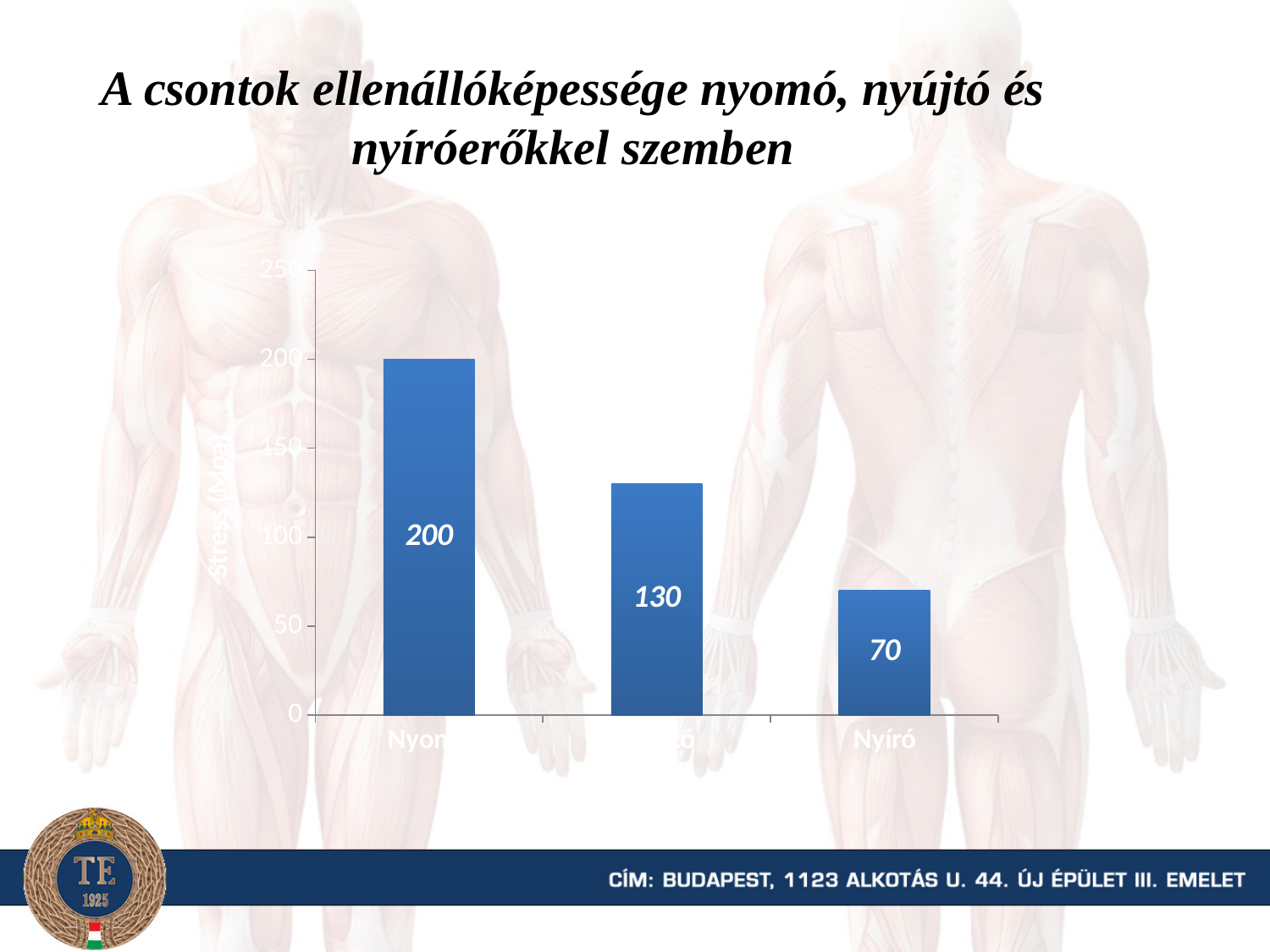
Which is larger, the middle bar or the Nyíró bar? the middle bar Do the bar values rise or fall from left to right across the chart? fall How many bars are plotted in the chart? 3 What is the value of the bar labelled Nyíró? 70 What is the value of the middle bar in the chart? 130 What is the value of the leftmost bar in the chart? 200 What is the difference between the middle bar and the Nyíró bar? 60 What type of chart is shown on the slide? bar chart What is the difference between the leftmost bar (200) and the Nyíró bar? 130 Is the value of the Nyíró bar greater or less than 100? less What is the highest value shown on the vertical axis? 250 Which bar has the lowest value? Nyíró